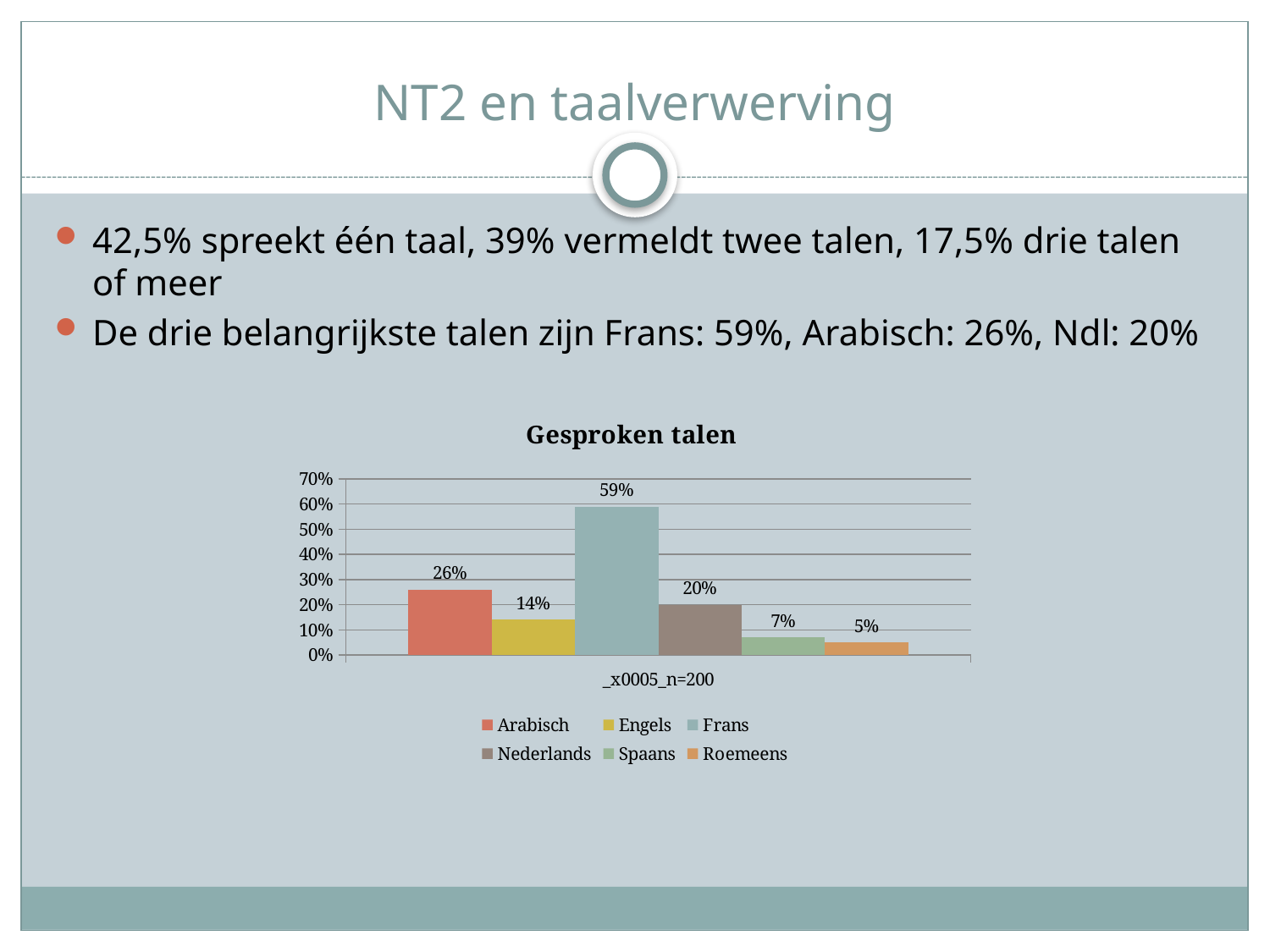
What is the value for Roemeens in the Gesproken talen chart? 5% Which is larger, the value for Engels or the value for Nederlands? Nederlands What is the difference between the values for Frans and Arabisch? 33% How many series does the legend of the Gesproken talen chart list? 6 Which language has the lowest value in the Gesproken talen chart? Roemeens What is the difference between the values for Nederlands and Spaans? 13% What is the value for Arabisch in the Gesproken talen chart? 26% Which language has the highest value in the Gesproken talen chart? Frans What is the label shown on the x axis of the chart? _x0005_n=200 What is the value for Frans in the Gesproken talen chart? 59% What kind of chart is shown on the slide? Bar chart What is the title of the chart on the slide? Gesproken talen